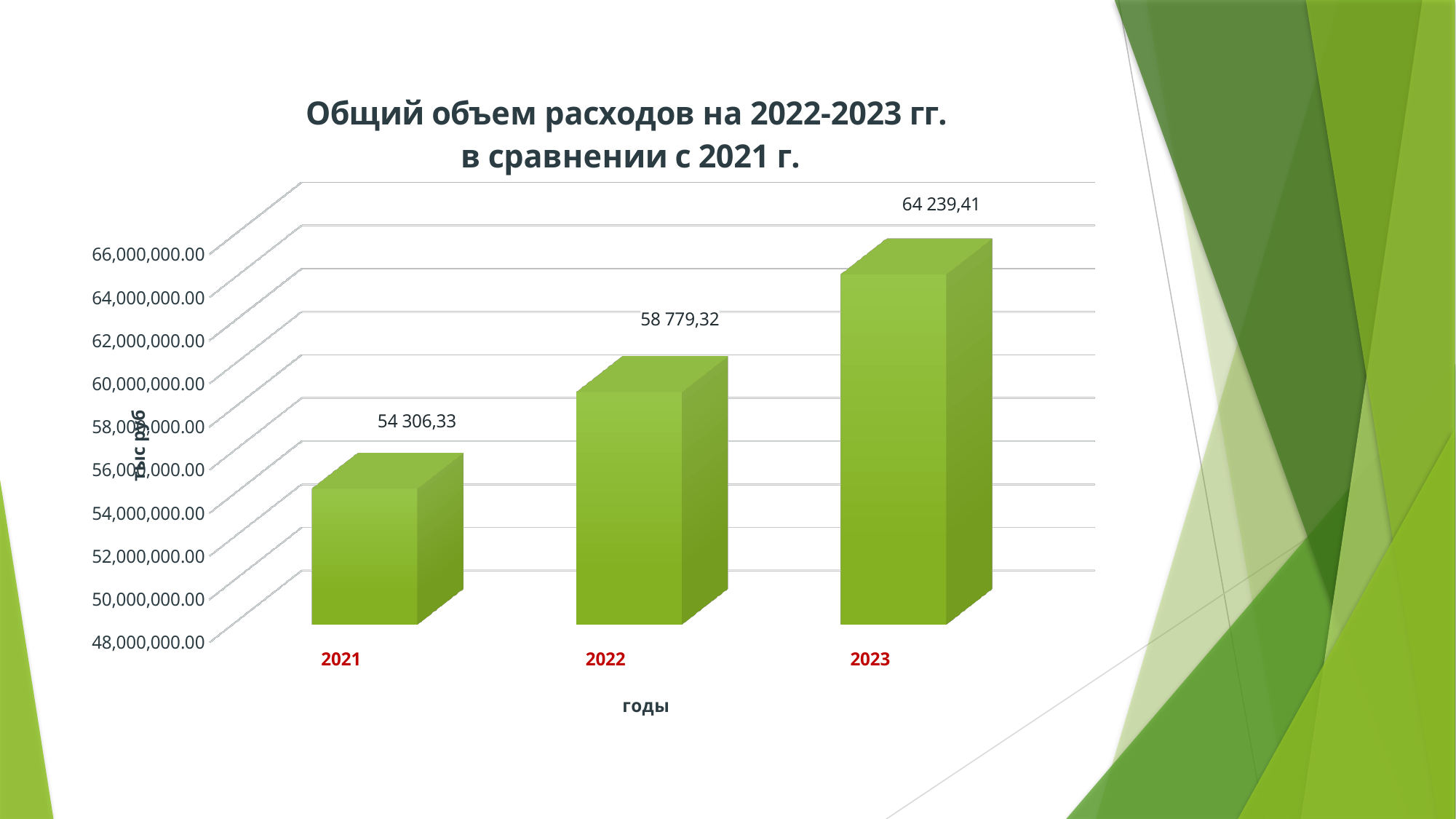
What is the value shown for 2022? 58 779,32 Is the bar for 2021 greater or less than 56,000,000.00 on the axis? less Which year has the highest value? 2023 What is the value shown for 2023? 64 239,41 Do the values rise or fall from 2021 to 2023? rise What is the difference between the values for 2023 and 2022? 5 460,09 Which year has the lowest value? 2021 What kind of chart is this? bar chart What is the difference between the values for 2022 and 2021? 4 472,99 Which is larger, the value for 2022 or the value for 2023? 2023 What is the value shown for 2021? 54 306,33 How many years are shown on the x axis? 3